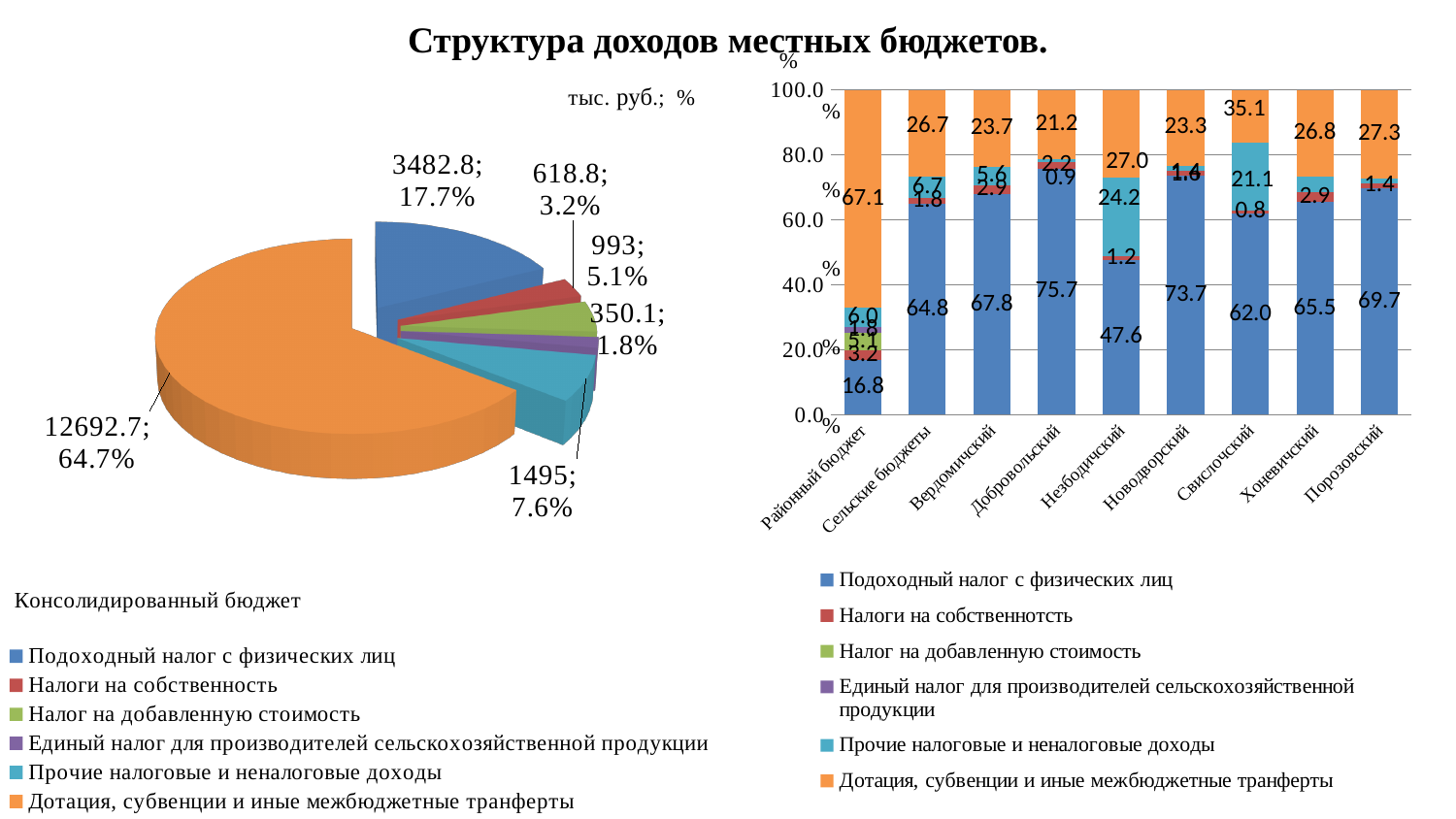
What type of chart is the left chart (Консолидированный бюджет)? pie chart In the stacked bar chart on the right, what is the value of Дотация, субвенции и иные межбюджетные трансферты for Районный бюджет? 67.1 In the pie chart (Консолидированный бюджет), which category has the largest slice? Дотация, субвенции и иные межбюджетные трансферты In the stacked bar chart on the right, which category has the lowest value for Подоходный налог с физических лиц? Районный бюджет How many categories are shown on the x axis of the stacked bar chart on the right? 9 In the pie chart (Консолидированный бюджет), what percentage share does Подоходный налог с физических лиц have? 17.7% In the stacked bar chart on the right, which category has the highest value for Подоходный налог с физических лиц? Добровольский In the pie chart (Консолидированный бюджет), which category has the smallest slice? Единый налог для производителей сельскохозяйственной продукции In the stacked bar chart on the right, what is the difference between the Дотация, субвенции и иные межбюджетные трансферты values for Свислочский and Порозовский? 7.8 How many series does the legend of the stacked bar chart on the right list? 6 In the pie chart (Консолидированный бюджет), what is the data label for Дотация, субвенции и иные межбюджетные трансферты? 12692.7; 64.7% In the stacked bar chart on the right, what is the value of Подоходный налог с физических лиц for Незбодичский? 47.6